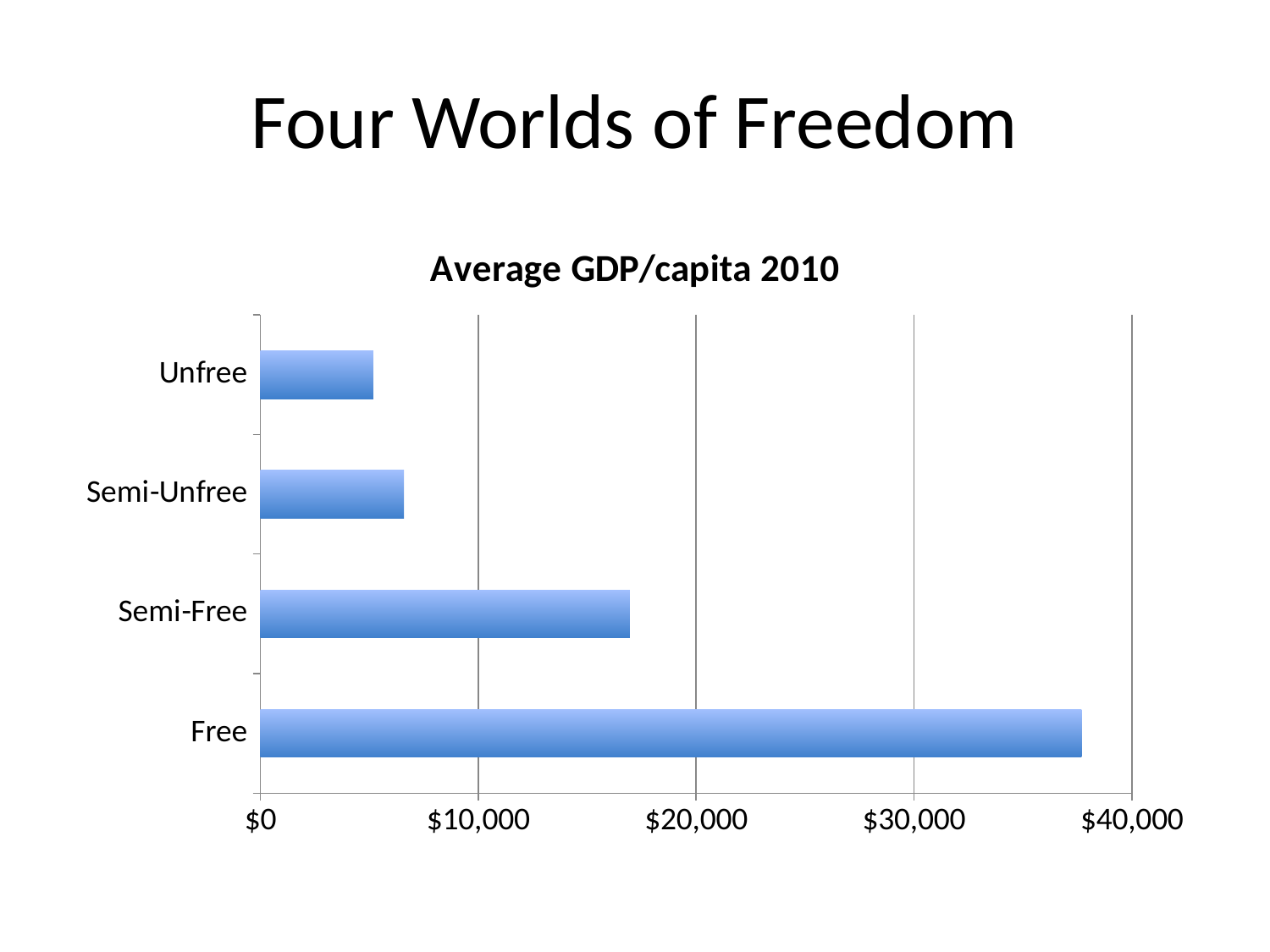
How many categories are plotted in the chart? 4 Which has a higher average GDP per capita, Semi-Free or Semi-Unfree? Semi-Free What is the title of the chart? Average GDP/capita 2010 Is the value for Unfree greater or less than $10,000? less Which has a higher average GDP per capita, Unfree or Semi-Unfree? Semi-Unfree What is the highest value shown on the horizontal axis? $40,000 Which category has the highest average GDP per capita? Free Is the value for Semi-Free greater or less than $10,000? greater What kind of chart is shown on the slide? bar chart Which category has the lowest average GDP per capita? Unfree Is the value for Free greater or less than $30,000? greater